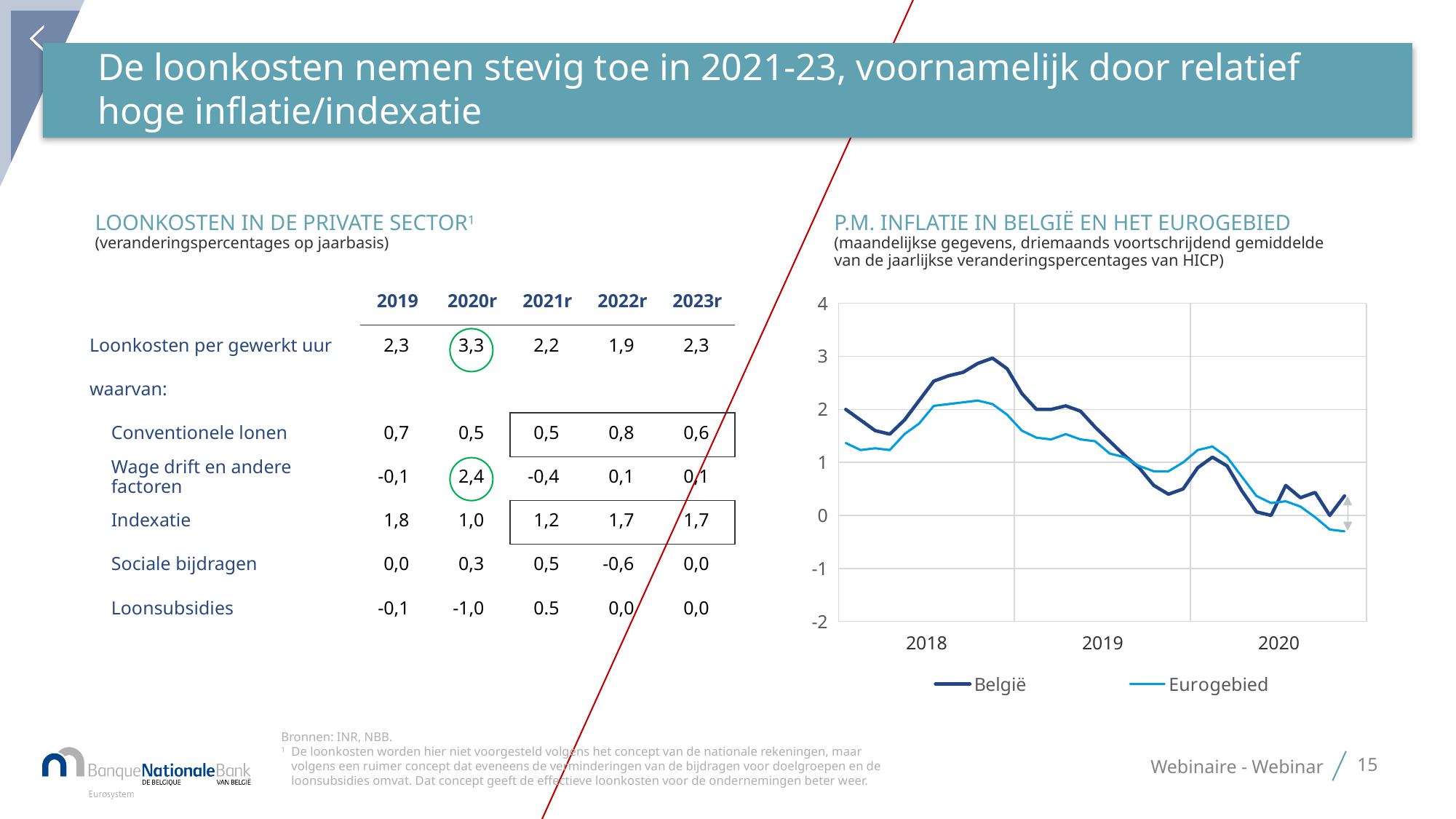
How many series does the legend of the inflation chart list? 2 In the inflation chart, which series reaches the highest value over the period shown? België In the inflation chart, is the first value of the Eurogebied line at the start of 2018 greater or less than 1? greater What are the two series named in the legend of the inflation chart? België and Eurogebied In the inflation chart, is the peak value of the Eurogebied line in 2018 greater or less than 3? less In the inflation chart, at the end of the period in 2020, which series is higher: België or Eurogebied? België In the inflation chart, do the values of the België line rise or fall overall from their 2018 peak to the end of 2020? Fall In the inflation chart, is the last value of the Eurogebied line in 2020 greater or less than 0? less What kind of chart is shown on the right side of the slide, titled "P.M. INFLATIE IN BELGIË EN HET EUROGEBIED"? Line chart How many year labels are shown on the x axis of the inflation chart? 3 What is the lowest value shown on the y axis of the inflation chart? -2